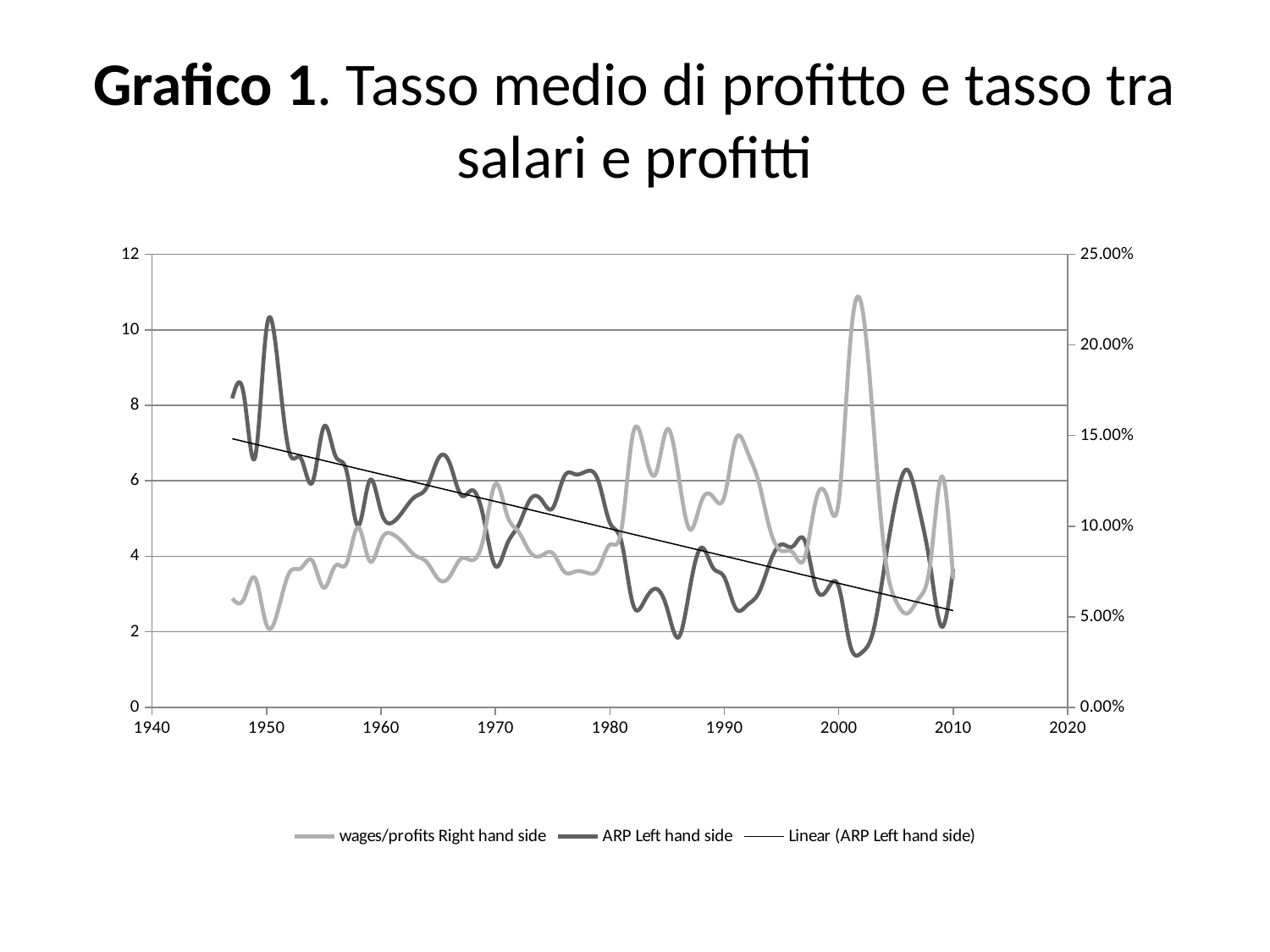
Around which labelled year does the ARP Left hand side series reach its highest peak? 1950 How many entries does the legend list? 3 Around which labelled year does the wages/profits series reach its highest peak? 2000 Does the linear trendline for ARP rise or fall from 1950 to 2010? fall What kind of chart is shown on the slide? line chart Overall, does the ARP Left hand side series rise or fall between 1950 and 2010? fall Is the value of the ARP Left hand side series at 1960 greater or less than 4? greater What is the title of the chart? Grafico 1. Tasso medio di profitto e tasso tra salari e profitti What is the highest value shown on the right-hand axis? 25.00%